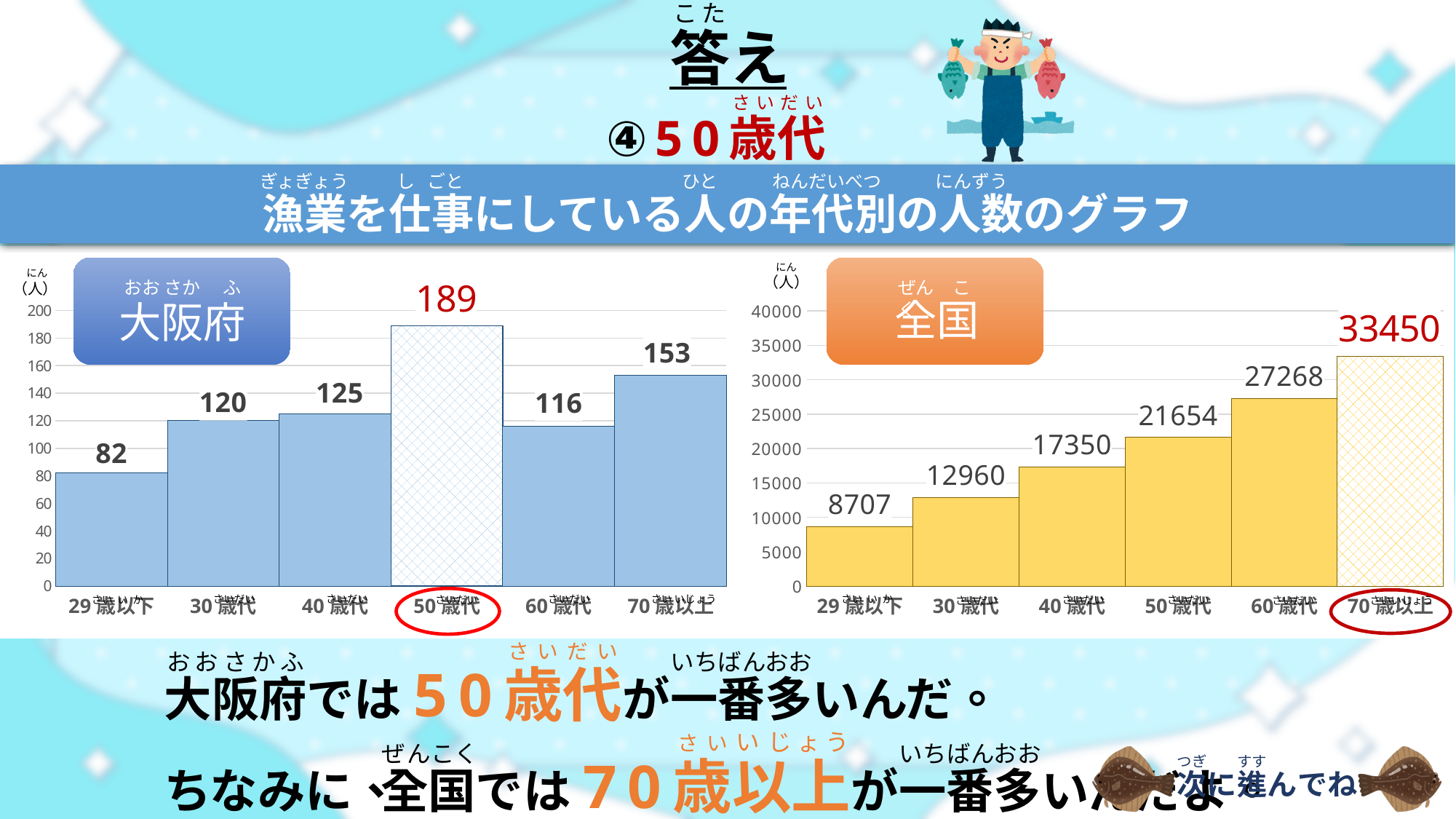
In the 大阪府 chart, which age group has the lowest value? 29歳以下 In the 大阪府 chart, what is the value for 29歳以下? 82 In the 大阪府 chart, what is the value for 50歳代? 189 In the 全国 chart, is the value for 50歳代 greater or less than 20000? greater In the 大阪府 chart, which is larger, the value for 40歳代 or the value for 60歳代? 40歳代 In the 全国 chart, do the values rise or fall from 29歳以下 to 70歳以上? rise How many age-group categories does the 全国 chart show? 6 In the 全国 chart, which age group has the highest value? 70歳以上 In the 全国 chart, what is the value for 60歳代? 27268 In the 全国 chart, what is the difference between the values for 70歳以上 and 29歳以下? 24743 What kind of chart is the 大阪府 chart? bar chart In the 大阪府 chart, what is the difference between the values for 50歳代 and 70歳以上? 36